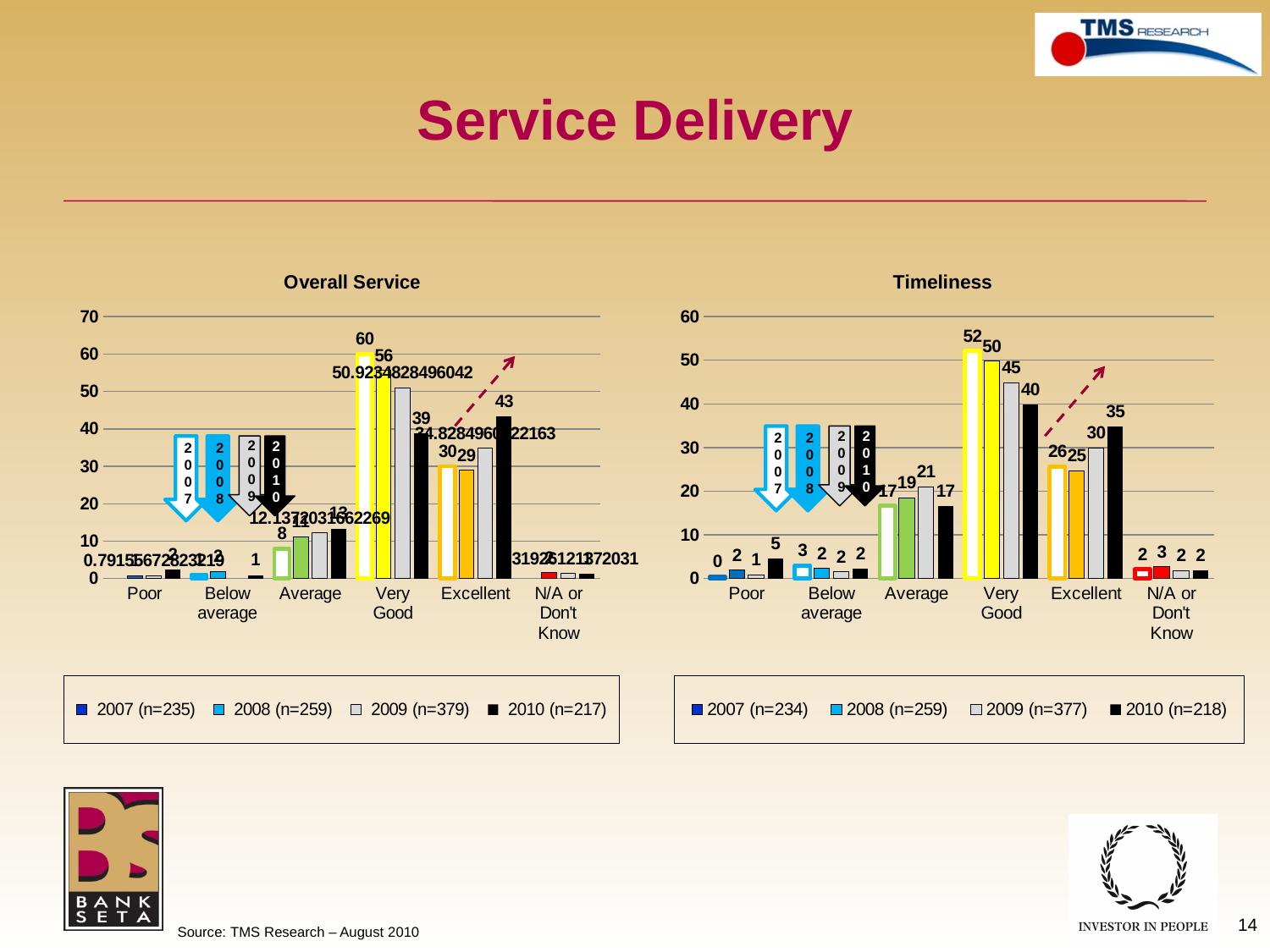
In the Overall Service chart, what is the value for Very Good in 2007? 60 In the Timeliness chart, which year has the highest value for Very Good? 2007 In the Overall Service chart, what is the value for Excellent in 2010? 43 In the Timeliness chart, what is the value for Excellent in 2010? 35 In the Timeliness chart, which is larger for Average: 2009 or 2010? 2009 How many series does the legend of the Timeliness chart list? 4 What kind of chart is the Overall Service chart? bar chart In the Timeliness chart, what is the difference between the Very Good values for 2007 and 2010? 12 How many categories are shown on the x axis of the Timeliness chart? 6 In the Timeliness chart, do the Very Good values rise or fall from 2007 to 2010? fall In the Timeliness chart, what is the value for Very Good in 2007? 52 In the Timeliness chart, what is the value for Poor in 2010? 5